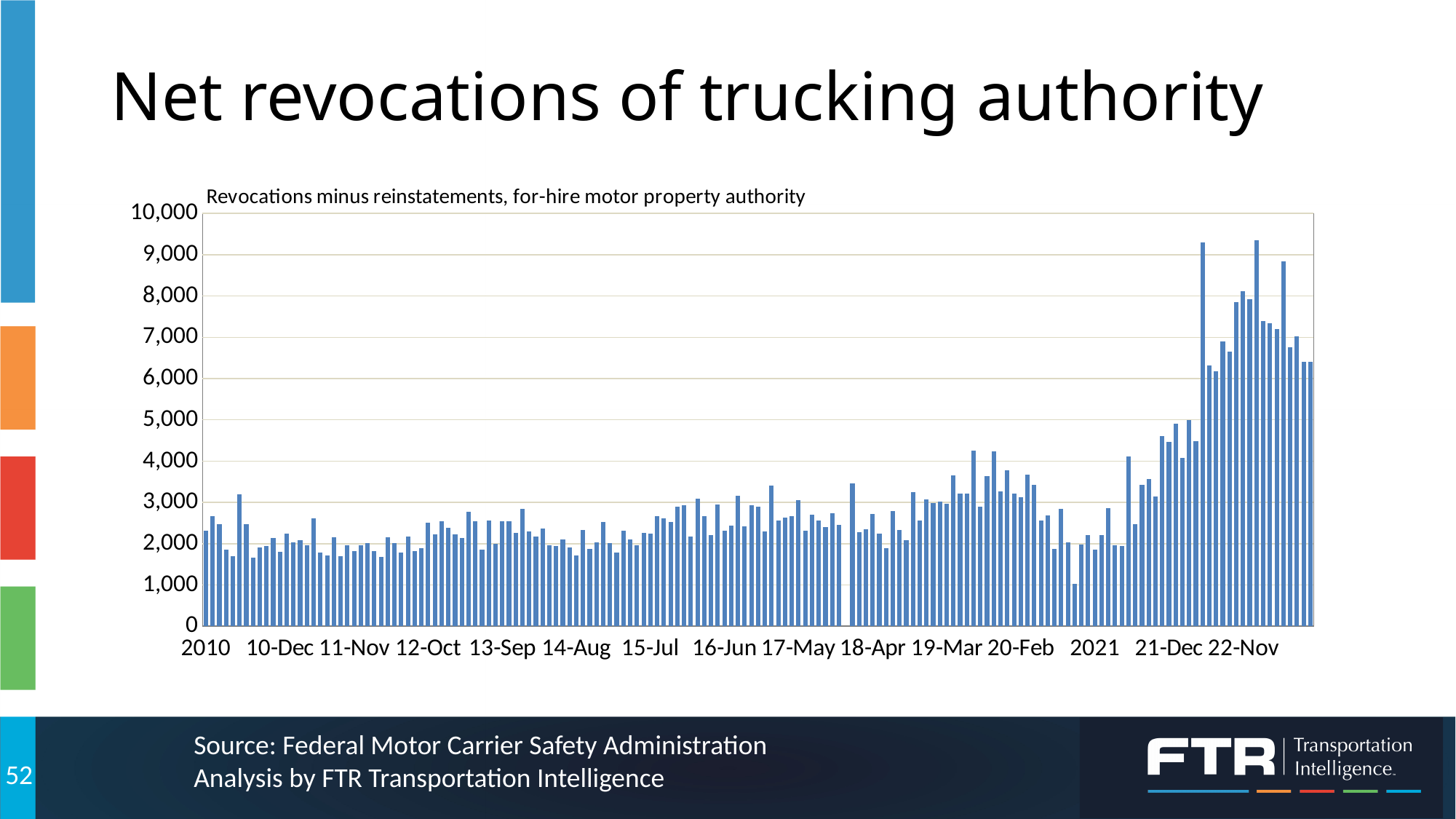
Is the lowest bar in the chart greater or less than 2,000? less Is the value for the first bar (2010) greater or less than 2,000? greater What kind of chart is shown on the slide? Bar chart Are all bars before the 2021 label greater or less than 5,000? less How many data series are plotted in the chart? 1 What subtitle describes the data plotted in the chart? Revocations minus reinstatements, for-hire motor property authority Which is larger, the value at the 2010 label or the value at the 22-Nov label? 22-Nov Overall, do net revocations rise or fall from 2010 to the end of the series? Rise What is the title of the slide's chart? Revocations minus reinstatements, for-hire motor property authority